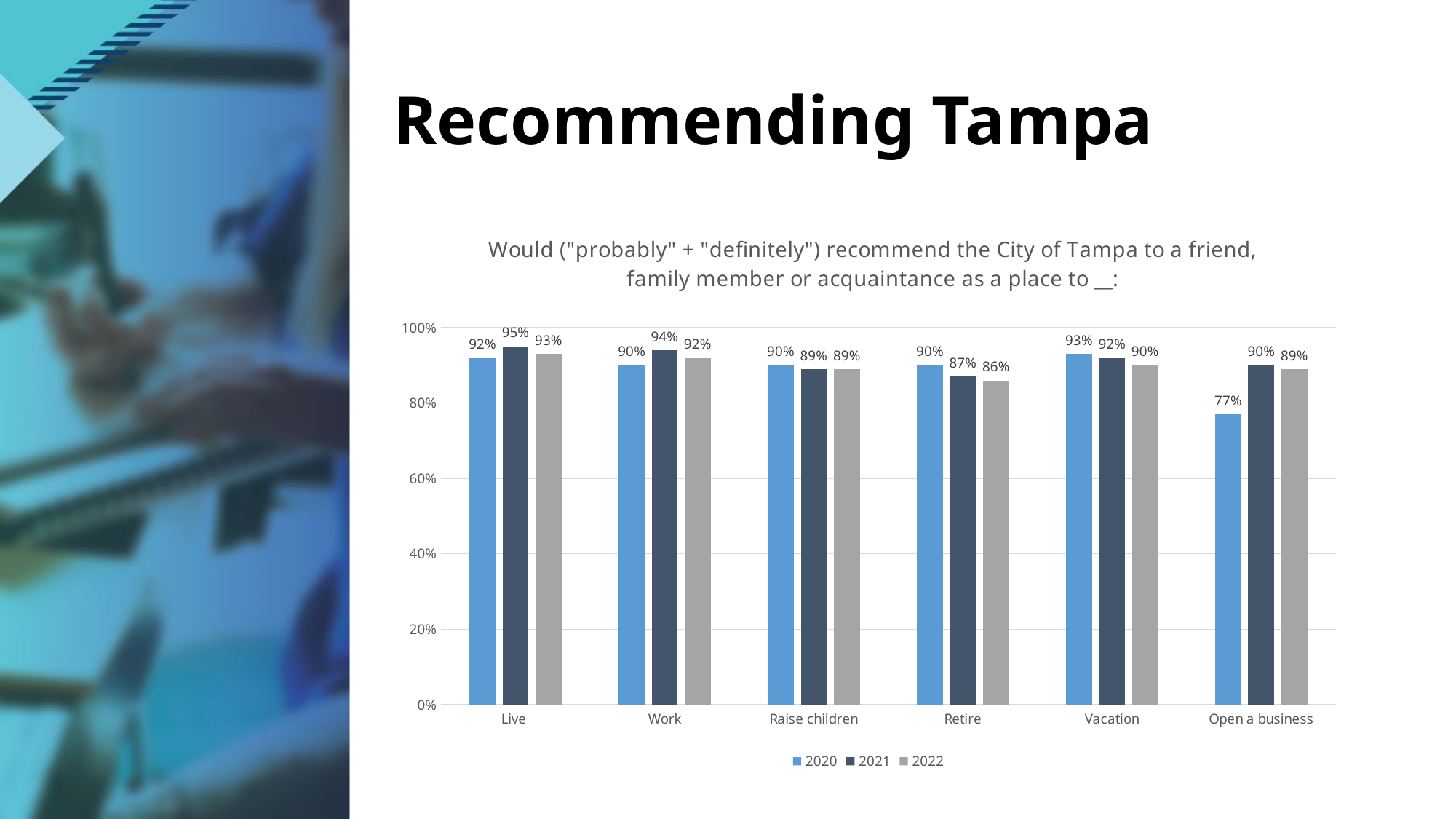
Which category has the lowest 2020 value? Open a business Which category has the highest 2021 value? Live How many categories are shown on the x axis? 6 Which is larger for Vacation, the 2020 value or the 2022 value? 2020 What kind of chart is shown on the slide? bar chart What is the difference between the 2021 and 2020 values for Open a business? 13% What is the 2022 value for Retire? 86% Is the 2020 value for Open a business greater or less than 80%? less What is the 2021 value for Live? 95% Which series is shown in light blue in the legend? 2020 How many series does the legend list? 3 What is the 2020 value for Open a business? 77%